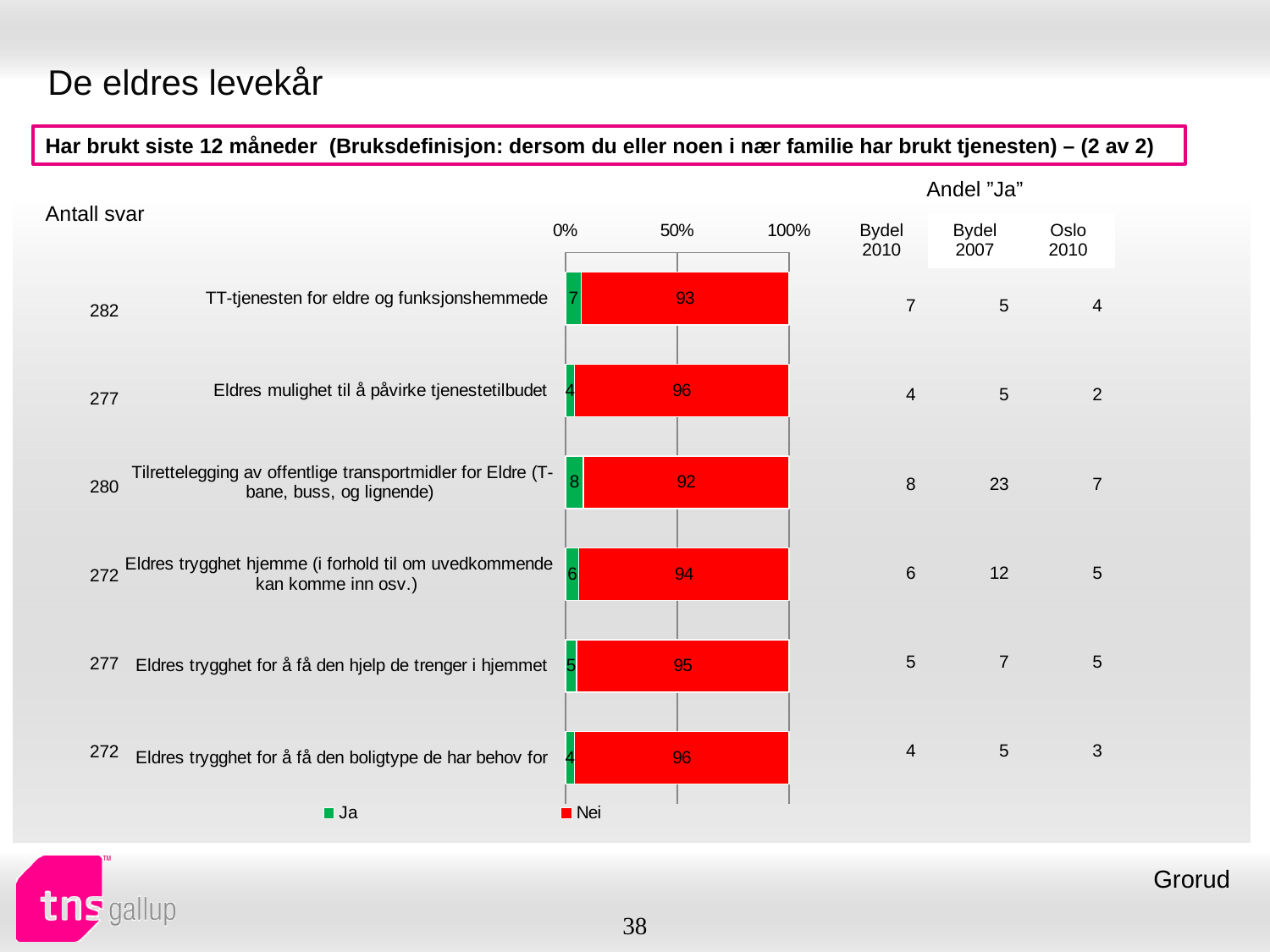
Which colour represents the "Nei" series in the chart? red What is the difference between the "Nei" values for "Eldres mulighet til å påvirke tjenestetilbudet" and "TT-tjenesten for eldre og funksjonshemmede"? 3 How many series does the chart legend list? 2 Which category has the lowest "Nei" value? Tilrettelegging av offentlige transportmidler for Eldre (T-bane, buss, og lignende) What kind of chart is shown on the slide? bar chart Which is larger: the "Ja" value for "TT-tjenesten for eldre og funksjonshemmede" or the "Ja" value for "Eldres trygghet hjemme (i forhold til om uvedkommende kan komme inn osv.)"? TT-tjenesten for eldre og funksjonshemmede What is the total of the stacked bar for "Eldres trygghet for å få den boligtype de har behov for"? 100 What is the "Nei" value for "TT-tjenesten for eldre og funksjonshemmede"? 93 What is the "Nei" value for "Eldres trygghet for å få den hjelp de trenger i hjemmet"? 95 Which category has the highest "Ja" value? Tilrettelegging av offentlige transportmidler for Eldre (T-bane, buss, og lignende) What is the "Ja" value for "Tilrettelegging av offentlige transportmidler for Eldre (T-bane, buss, og lignende)"? 8 How many categories are plotted in the chart? 6